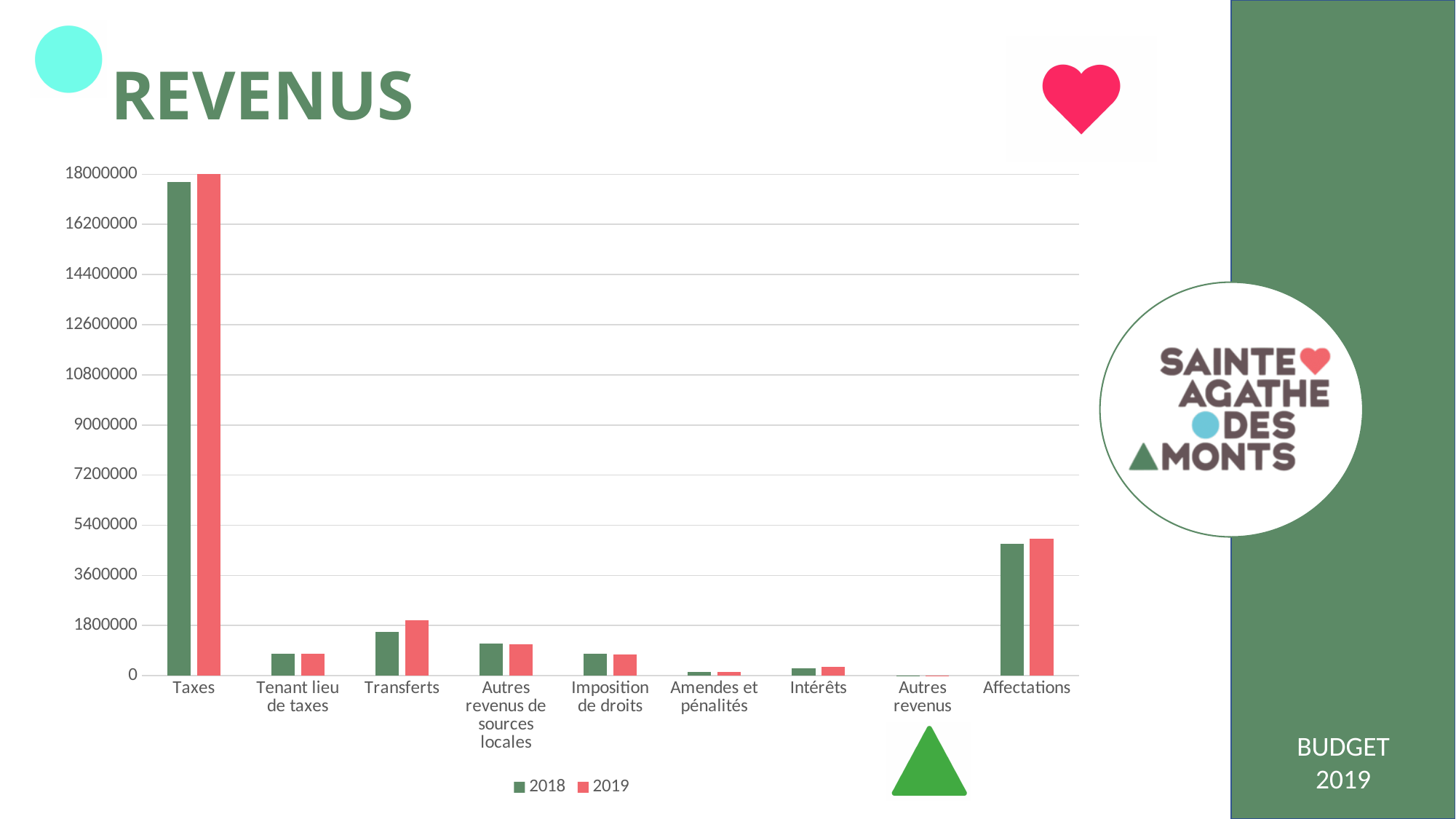
For Transferts, which year has the larger value, 2018 or 2019? 2019 How many series does the legend list? 2 How many categories are shown on the x axis? 9 What is the title of the chart? REVENUS Which category has the highest revenue in 2019? Taxes What kind of chart is shown on the slide? bar chart Is the 2018 value for Taxes greater or less than 16200000? greater Which category has the second-highest revenue in 2019? Affectations Is the 2019 value for Transferts greater or less than 1800000? greater Which colour represents the 2019 series in the legend? red Is the 2018 value for Affectations greater or less than 5400000? less Which category has the lowest revenue in 2018? Autres revenus